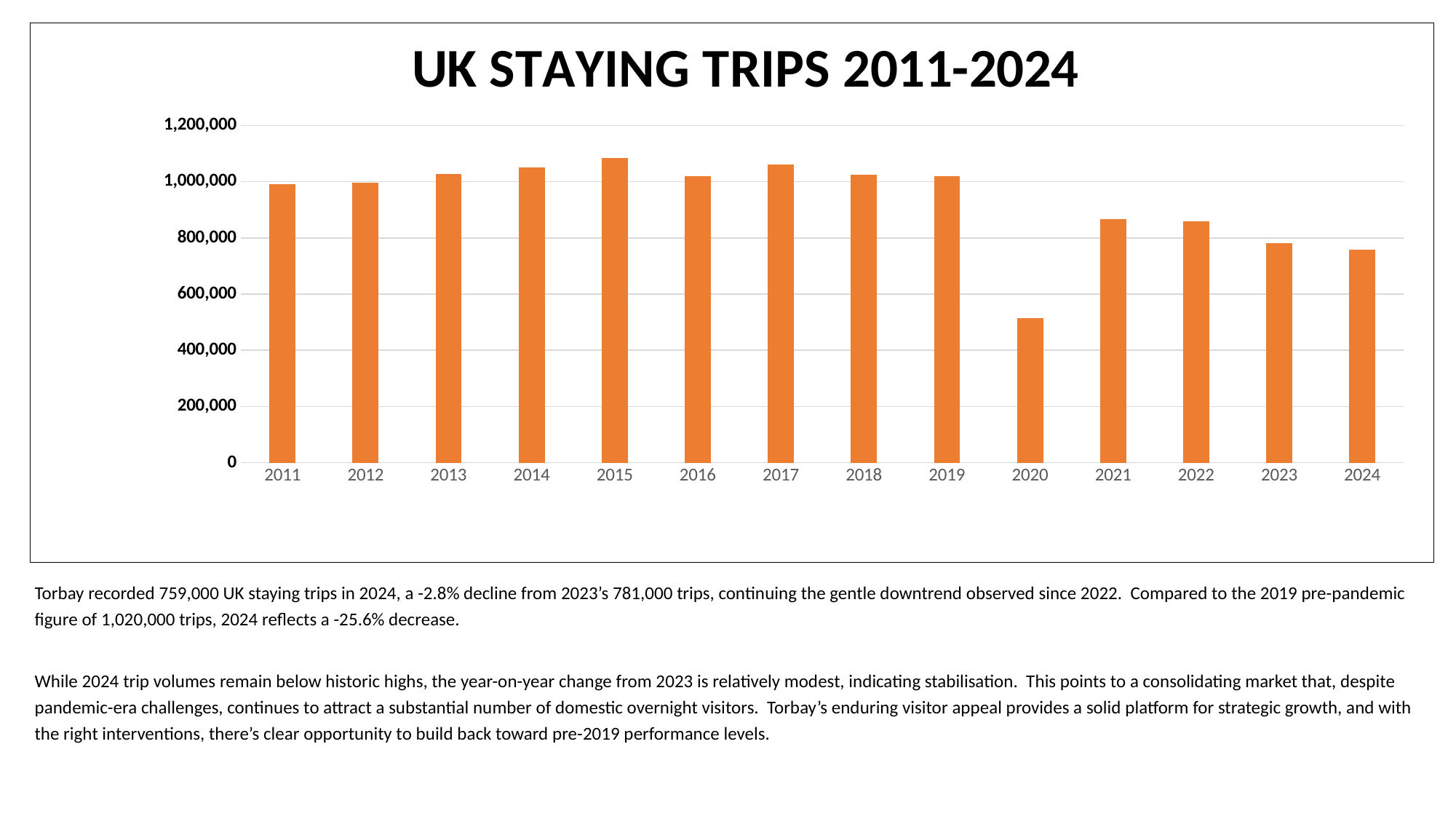
What is the title of the chart? UK STAYING TRIPS 2011-2024 Do the values rise or fall from 2021 to 2024? fall Is the value for 2015 greater or less than 1,000,000? greater How many years are shown on the x axis of the chart? 14 Is the value for 2020 greater or less than 600,000? less What kind of chart is shown on the slide? bar chart Which year has more UK staying trips, 2021 or 2023? 2021 According to the slide, how many UK staying trips were recorded in 2024? 759,000 Is the value for 2021 greater or less than 800,000? greater Which year has the lowest number of UK staying trips? 2020 According to the slide, how many UK staying trips were recorded in 2019? 1,020,000 Which year has the highest number of UK staying trips? 2015